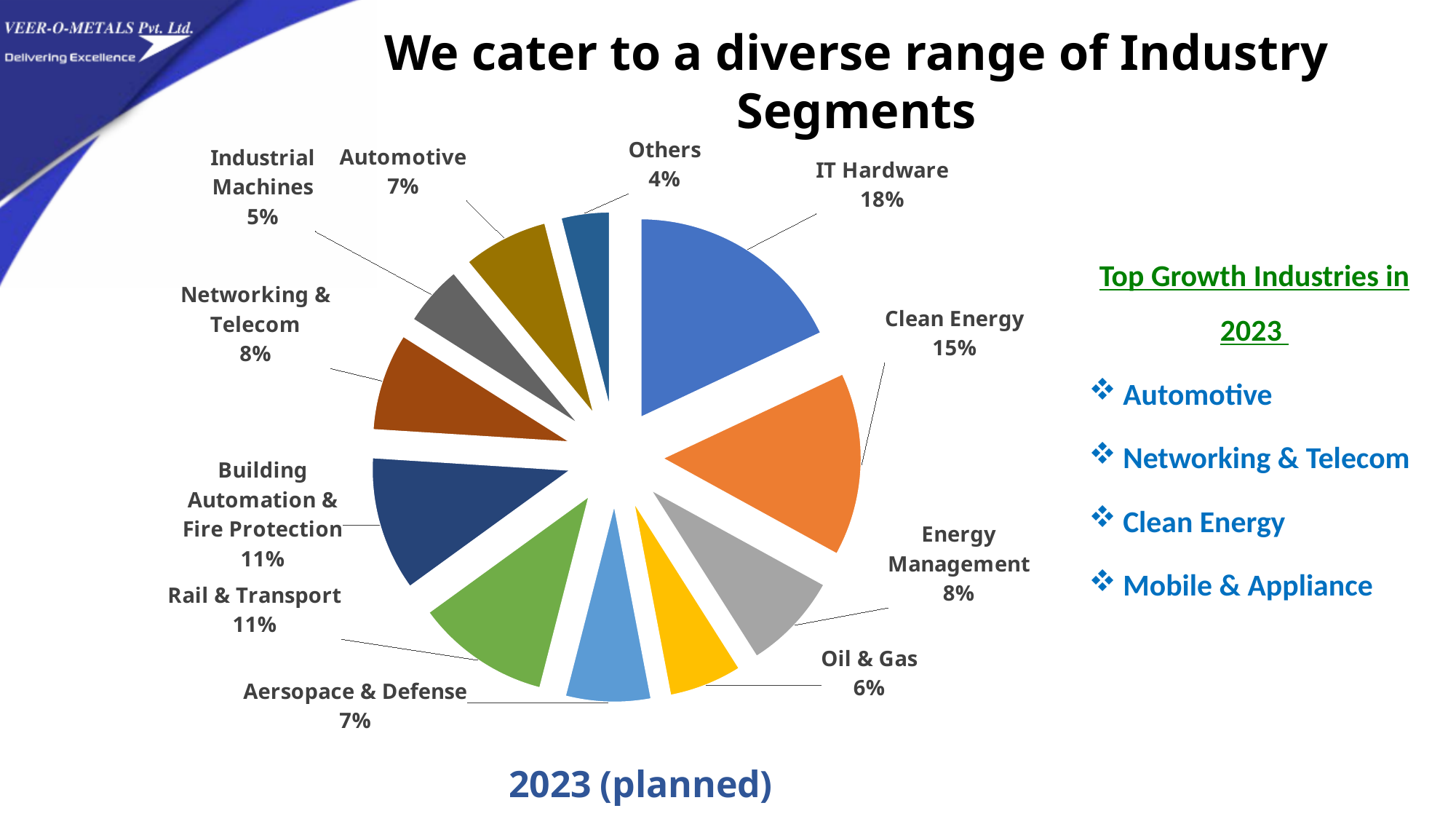
What percentage is shown for Clean Energy? 15% What percentage is shown for Others? 4% Which industry segment has the smallest share of the pie? Others How many segments are shown in the pie chart? 11 What is the combined share of Building Automation & Fire Protection and Rail & Transport? 22% Which industry segment has the largest share of the pie? IT Hardware What is the label shown beneath the pie chart? 2023 (planned) What is the difference in percentage points between IT Hardware and Clean Energy? 3 What is the value for Rail & Transport? 11% What kind of chart is shown on the slide? pie chart What share of the pie does IT Hardware have? 18% Which has a larger share, Networking & Telecom or Oil & Gas? Networking & Telecom